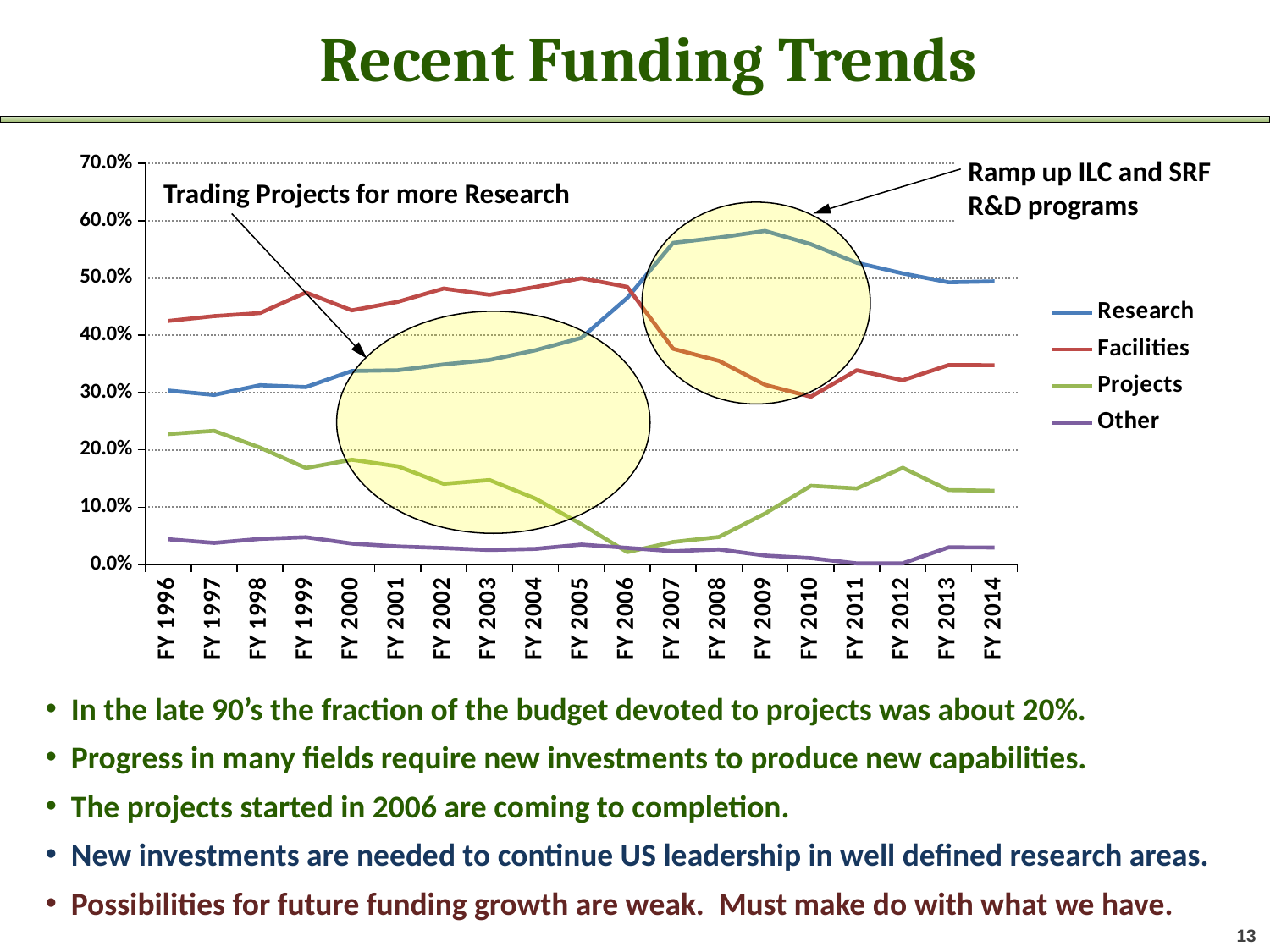
Is the value for Facilities in FY 1996 greater or less than 40.0%? greater How many fiscal years are plotted along the x axis? 19 Which series has the lowest value in FY 2014? Other Is the value for Research in FY 1996 greater or less than 40.0%? less How many series does the legend list? 4 In FY 1996, which is larger, Facilities or Research? Facilities Is the value for Projects in FY 2006 greater or less than 10.0%? less In FY 2014, which is larger, Research or Facilities? Research What is the title of the chart? Recent Funding Trends Does the Research line rise or fall from FY 2009 to FY 2014? fall What kind of chart is shown on the slide? line chart